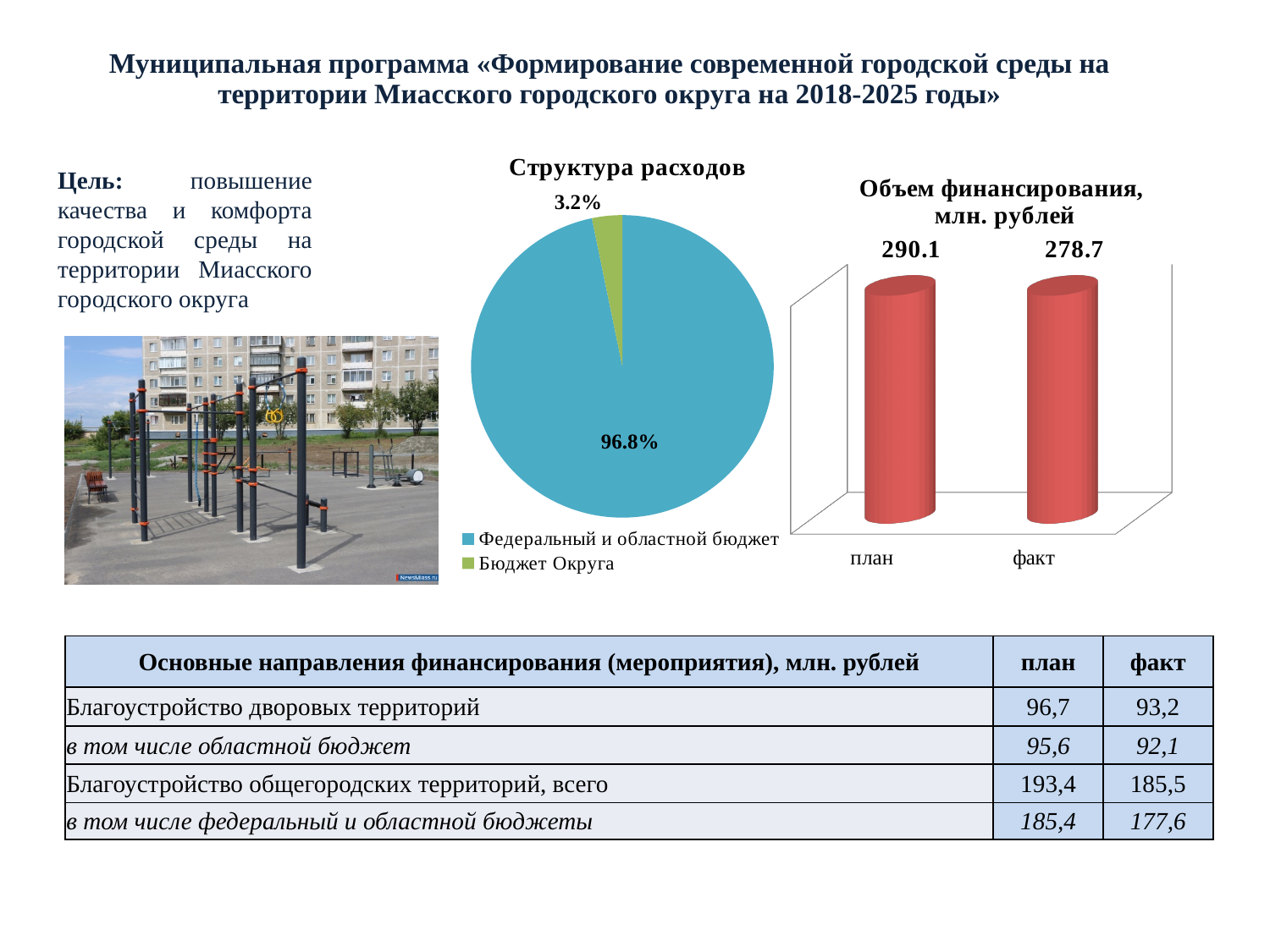
In the chart titled «Объем финансирования, млн. рублей», what is the difference between «план» and «факт»? 11.4 How many bars are shown in the chart titled «Объем финансирования, млн. рублей»? 2 In the chart titled «Объем финансирования, млн. рублей», what is the value for «факт»? 278.7 In the chart titled «Структура расходов», what share does «Бюджет Округа» have? 3.2% In the chart titled «Объем финансирования, млн. рублей», which is larger, «план» or «факт»? план What kind of chart is the one titled «Структура расходов»? Pie chart In the chart titled «Структура расходов», which slice is the largest? Федеральный и областной бюджет In the chart titled «Структура расходов», what share does «Федеральный и областной бюджет» have? 96.8% In the chart titled «Структура расходов», which slice is the smallest? Бюджет Округа How many entries does the legend of the chart titled «Структура расходов» list? 2 What kind of chart is the one titled «Объем финансирования, млн. рублей»? Bar chart In the chart titled «Объем финансирования, млн. рублей», what is the value for «план»? 290.1